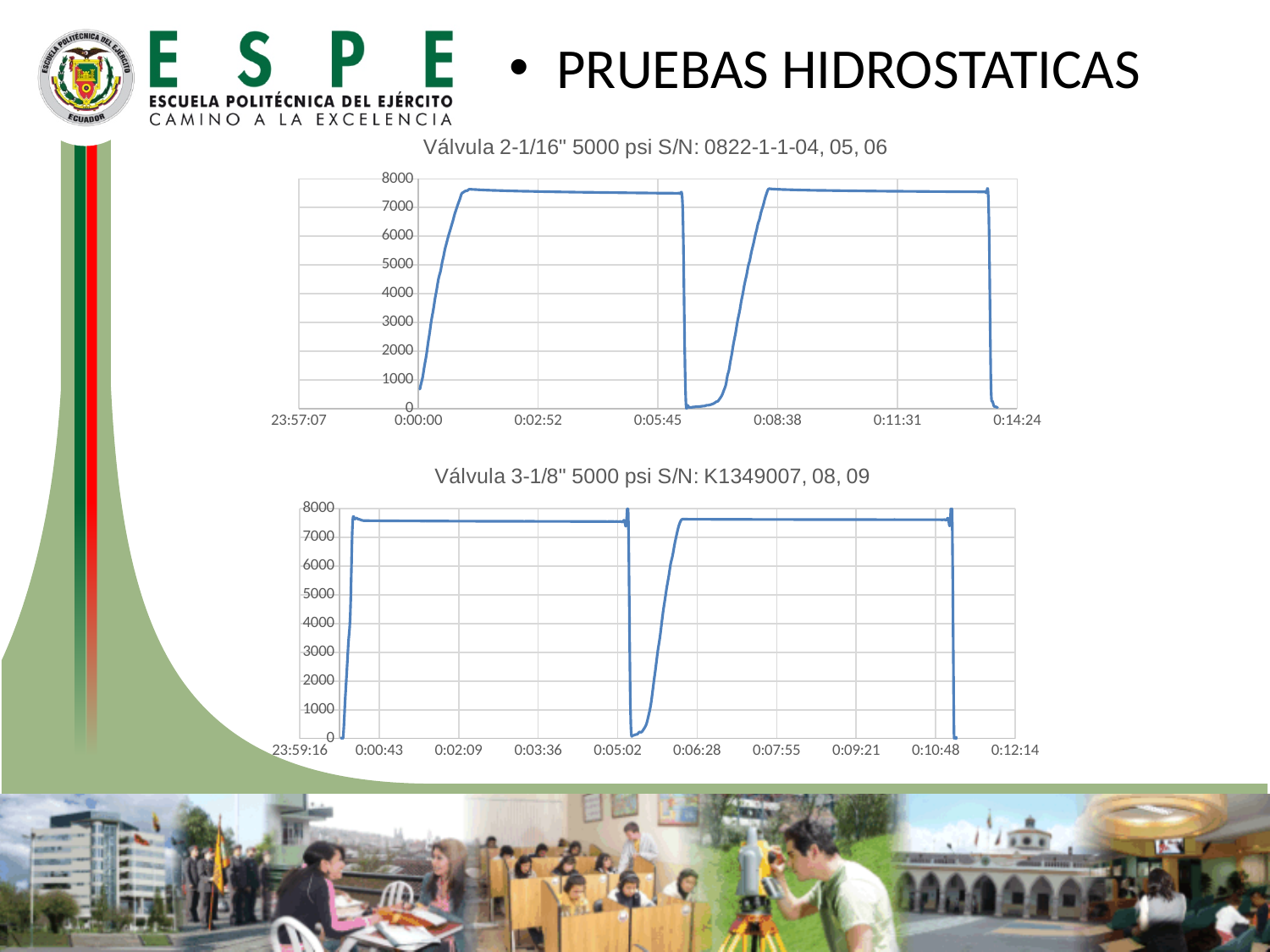
In the bottom chart, is the value at 0:05:02 greater or less than 1000? greater What kind of chart is the bottom chart titled "Válvula 3-1/8" 5000 psi S/N: K1349007, 08, 09"? Line chart In the top chart, is the value at 0:02:52 greater or less than 7000? greater In the bottom chart, is the value at 0:07:55 greater or less than 7000? greater What is the title of the top chart on the slide? Válvula 2-1/16" 5000 psi S/N: 0822-1-1-04, 05, 06 What kind of chart is the top chart titled "Válvula 2-1/16" 5000 psi S/N: 0822-1-1-04, 05, 06"? Line chart What is the title of the bottom chart on the slide? Válvula 3-1/8" 5000 psi S/N: K1349007, 08, 09